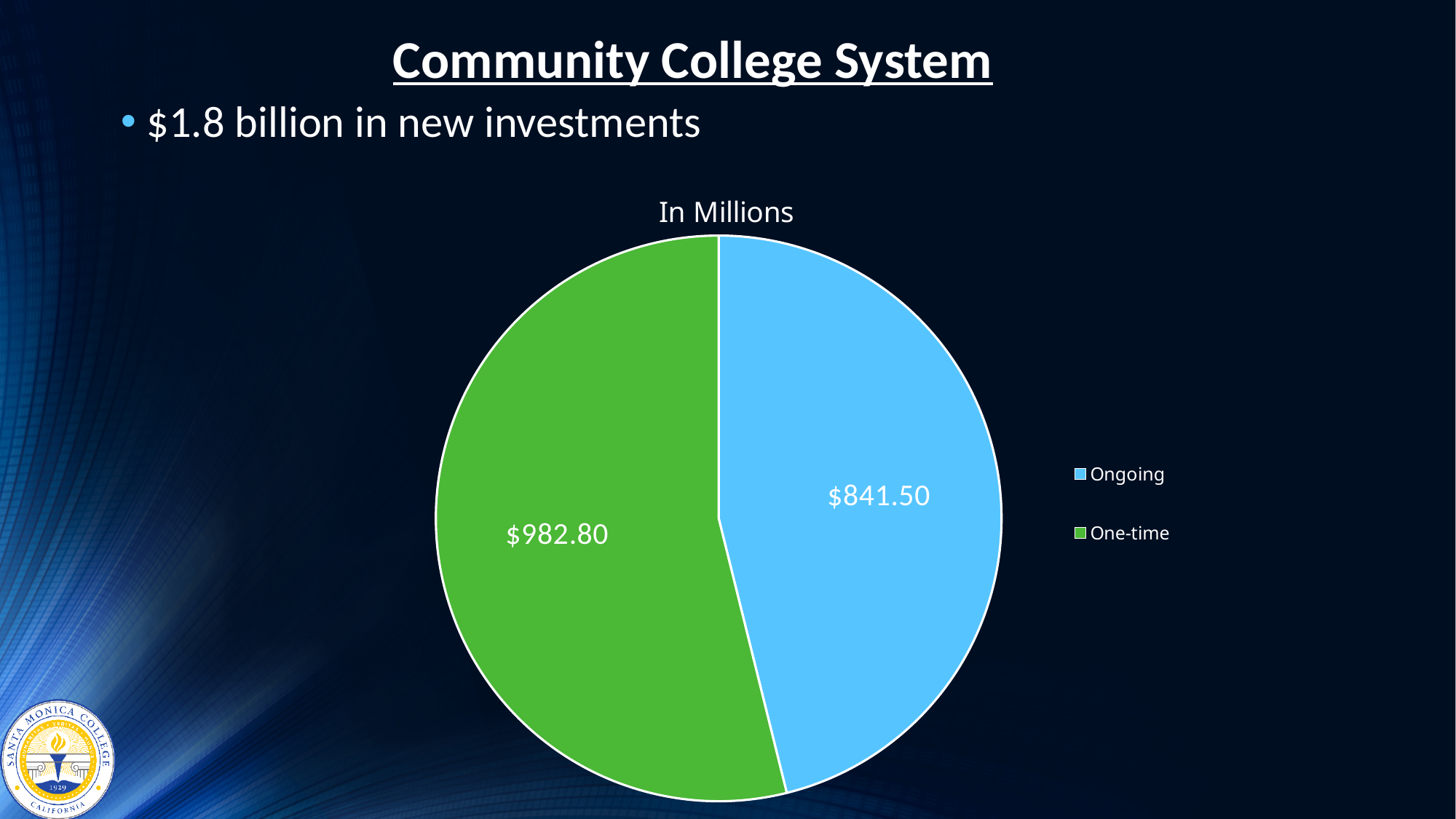
What type of chart is shown on the slide? pie chart Which slice is the smallest? Ongoing How many entries does the legend list? 2 What colour is the One-time slice? green How many slices does the pie chart have? 2 What is the value of the One-time slice? $982.80 Which slice is the largest? One-time What is the difference between the One-time and Ongoing values? $141.30 What is the value of the Ongoing slice? $841.50 Which is larger, Ongoing or One-time? One-time What is the total of the two slices? $1,824.30 What is the title of the chart? In Millions